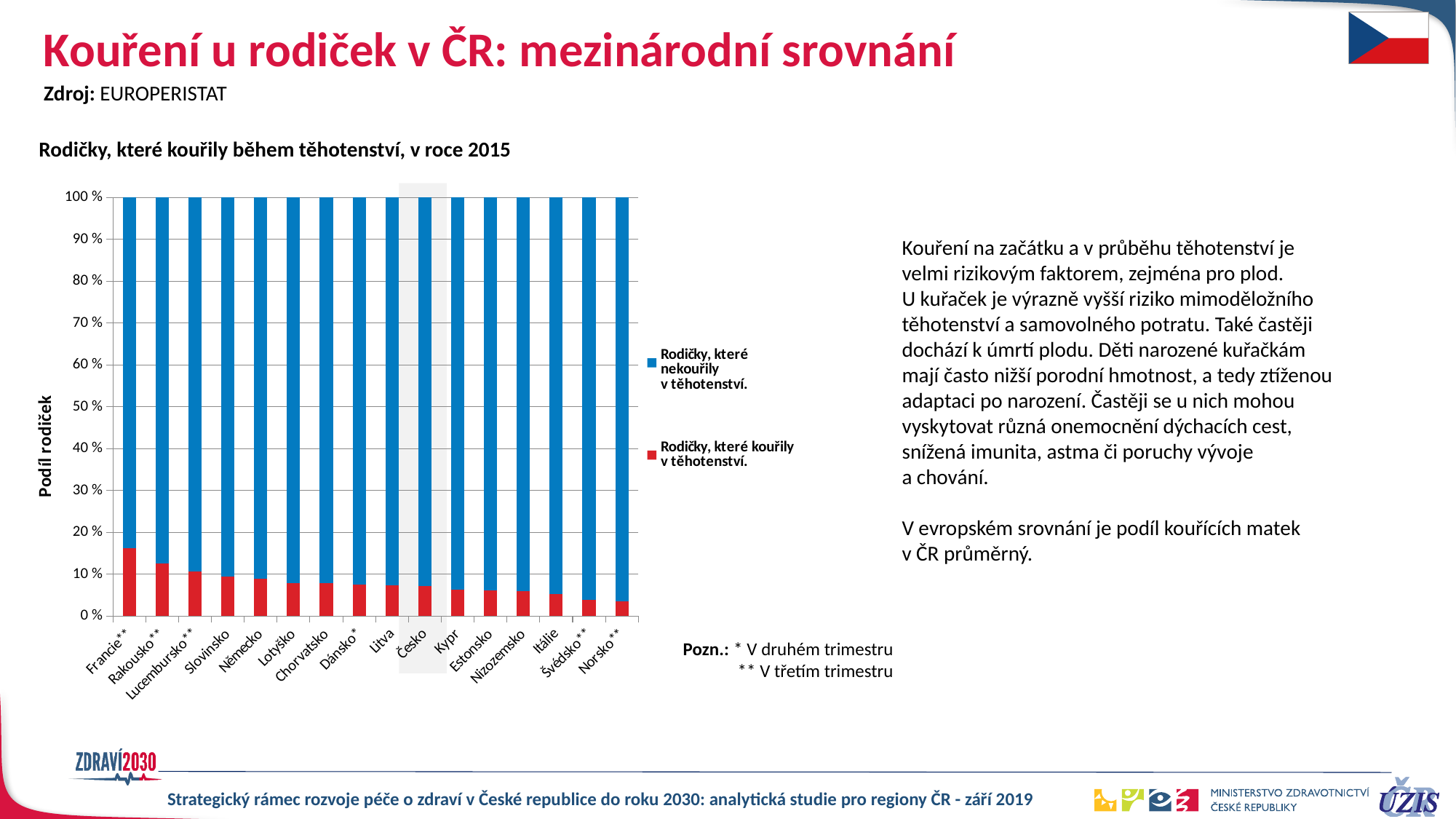
Does the share of mothers who smoked during pregnancy rise or fall from left to right along the x axis? fall Is the share of mothers who smoked during pregnancy in Francie greater or less than 20 %? less Is the share of mothers who smoked during pregnancy in Česko greater or less than 10 %? less Which country has a larger share of mothers who smoked during pregnancy, Rakousko or Itálie? Rakousko Which country has the lowest share of mothers who smoked during pregnancy (red segment)? Norsko What is the total of each stacked bar in the chart? 100 % How many countries are shown on the x axis of the chart? 16 Which country has the highest share of mothers who smoked during pregnancy (red segment)? Francie Is the share of mothers who smoked during pregnancy in Francie greater or less than 10 %? greater What kind of chart is shown on the slide? Stacked bar chart How many series does the chart legend list? 2